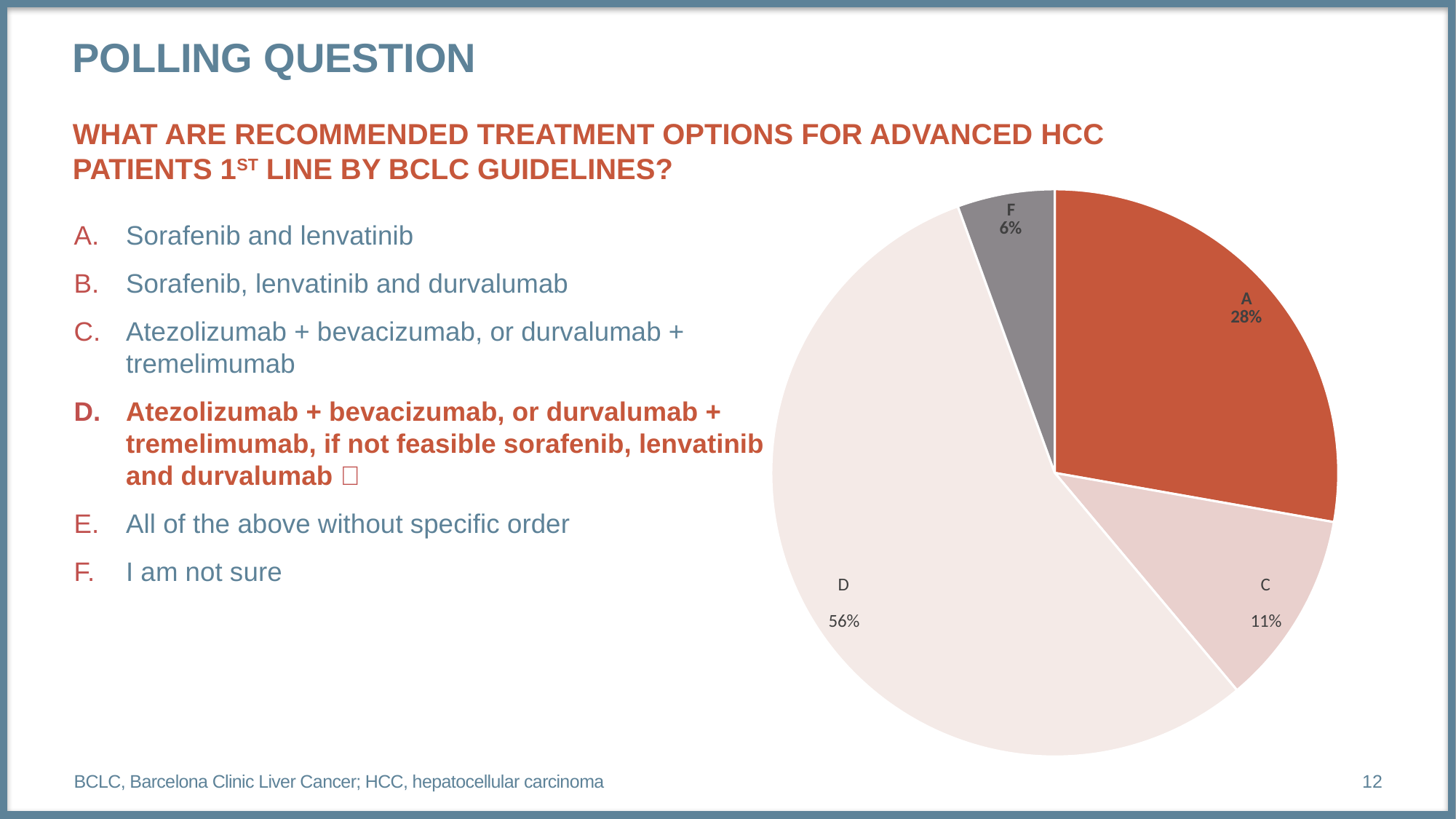
What percentage of the pie is labelled D? 56% What percentage of the pie is labelled C? 11% How many slices does the pie chart have? 4 Which slice of the pie is coloured dark grey? F What percentage of the pie is labelled F? 6% Which slice is larger, A or C? A What is the difference in percentage points between slice D and slice A? 28 What percentage of the pie is labelled A? 28% Which slice of the pie is the smallest? F What kind of chart is shown on the slide? pie chart What is the combined percentage of slices A and C? 39% Which slice of the pie is the largest? D